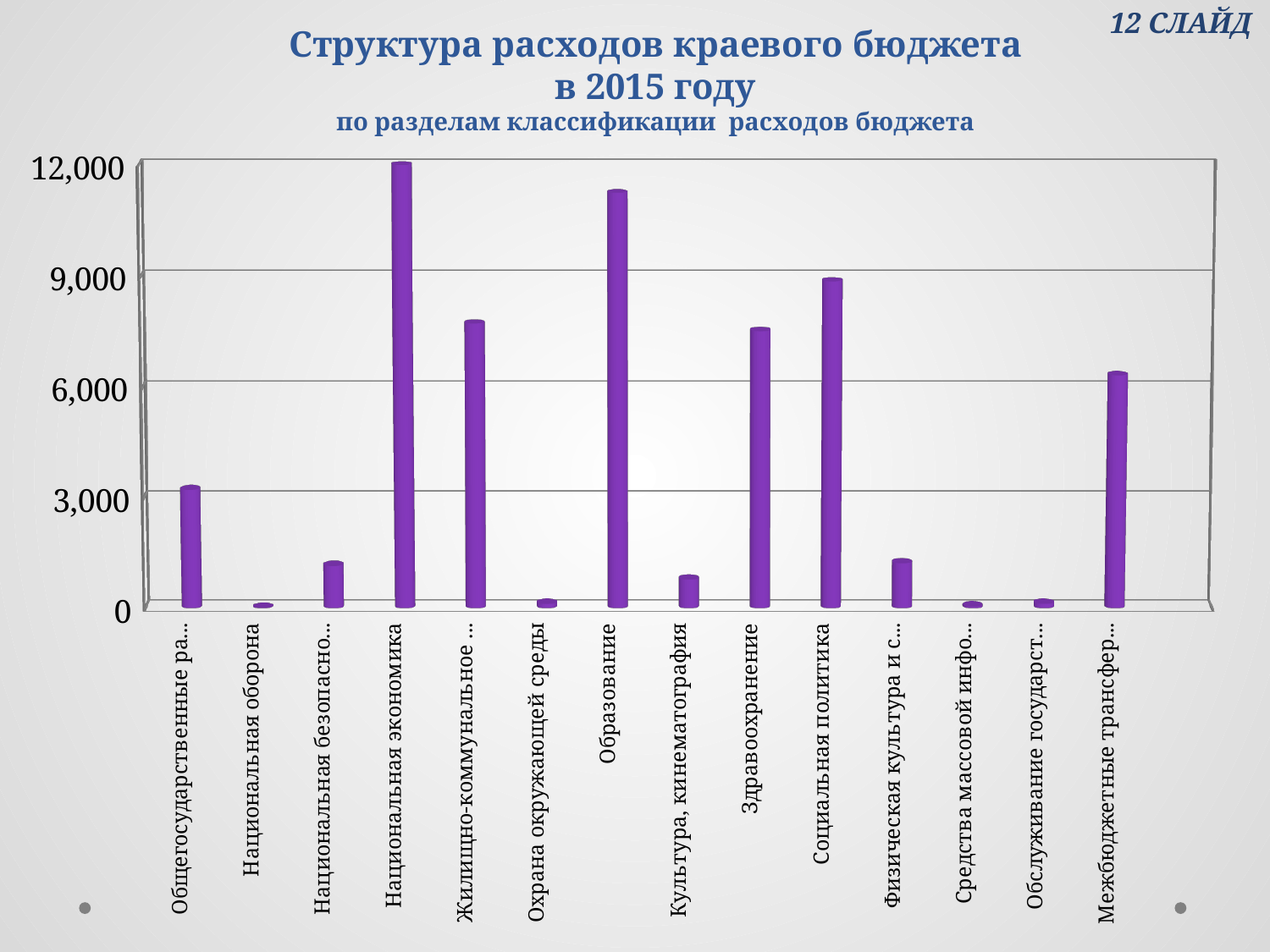
Which is larger, the value for Социальная политика or the value for Здравоохранение? Социальная политика Is the value for Образование greater or less than 9,000? greater What colour are the bars in the chart? purple What kind of chart is shown on the slide? bar chart Is the value for Здравоохранение greater or less than 6,000? greater What is the main title of the chart? Структура расходов краевого бюджета в 2015 году Which category has the highest value in the chart? Национальная экономика Which is larger, the value for Образование or the value for Здравоохранение? Образование Is the value for Охрана окружающей среды greater or less than 3,000? less How many categories (bars) are plotted in the chart? 14